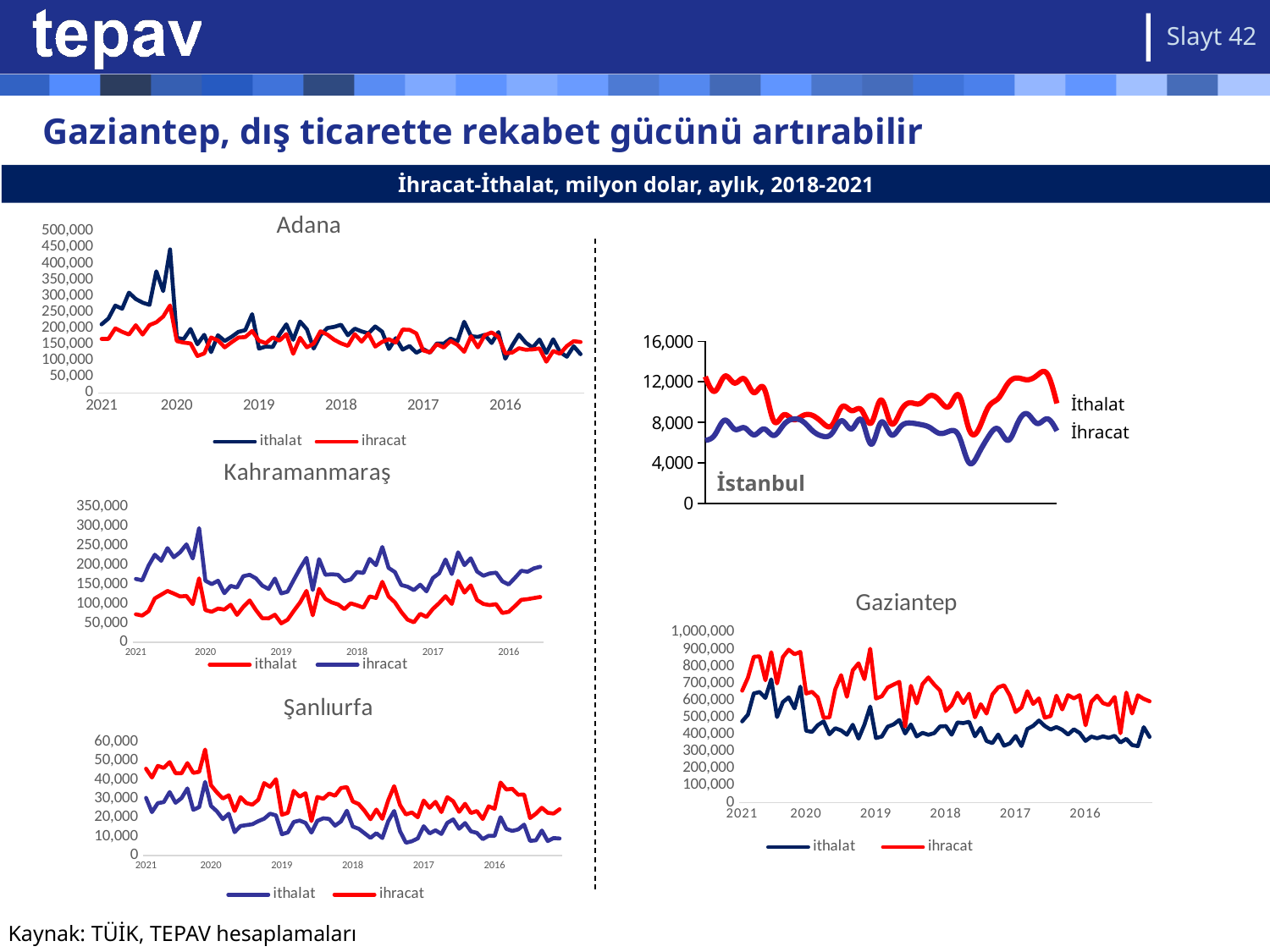
What kind of chart is the Adana chart? line chart In the Adana chart, is ithalat higher at the 2021 end or the 2016 end of the x axis? 2021 end How many series does the legend of the Gaziantep chart list? 2 In the Kahramanmaraş chart, is the highest ihracat value greater or less than 250,000? greater In the Gaziantep chart, is the highest ithalat value greater or less than 800,000? less In the Gaziantep chart, which series is generally higher, ithalat or ihracat? ihracat In the Adana chart, is the highest ithalat value greater or less than 400,000? greater How many city charts are shown on the slide? 5 What is the title shown in the banner above the charts? İhracat-İthalat, milyon dolar, aylık, 2018-2021 In the Kahramanmaraş chart, which series is generally higher, ithalat or ihracat? ihracat